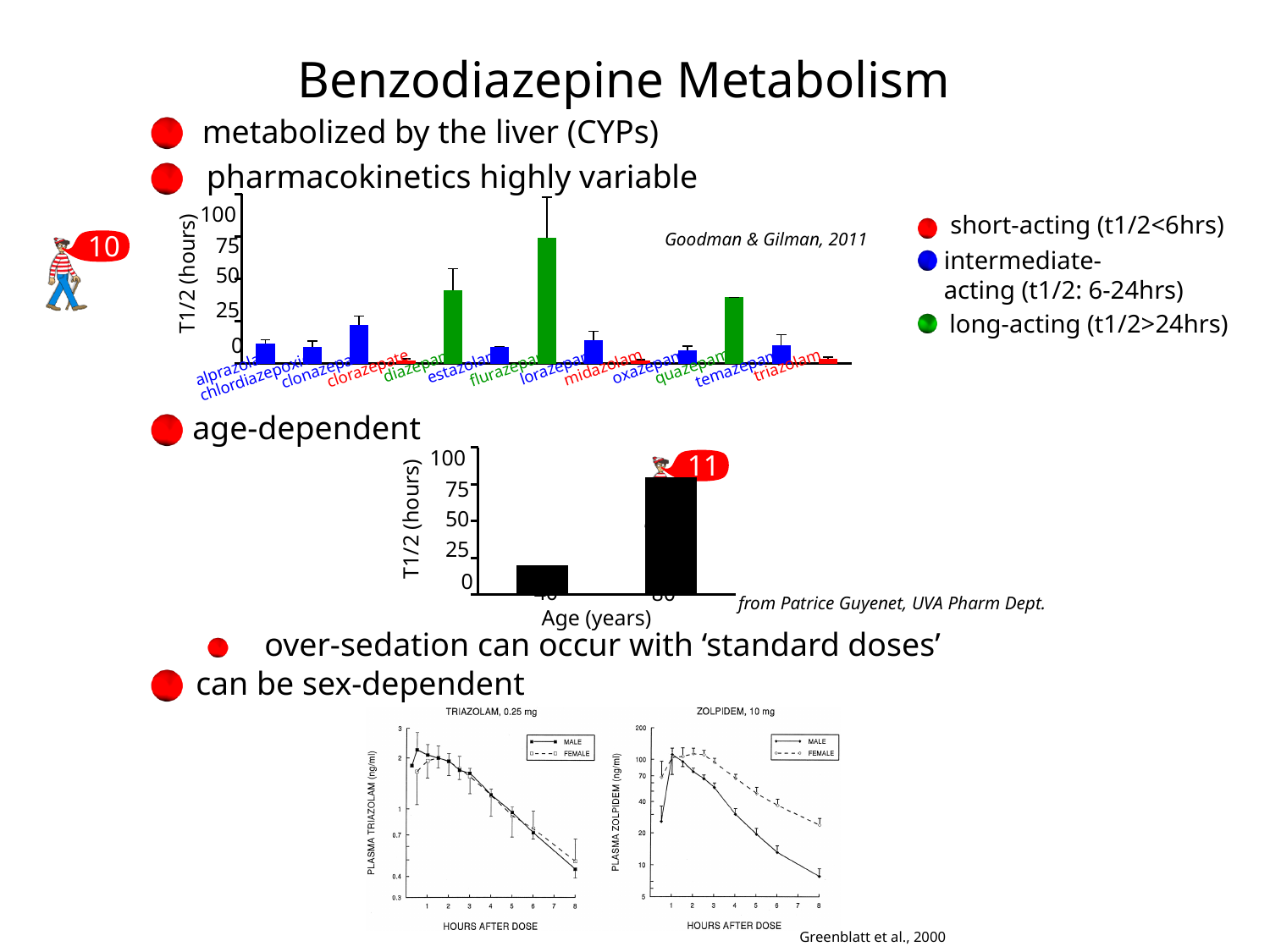
In the middle chart of T1/2 (hours) versus Age (years), how many bars are plotted? 2 In the bottom-left TRIAZOLAM, 0.25 mg chart, how many series does the legend list? 2 In the top T1/2 (hours) chart, what colour are the bars for long-acting drugs? green In the top T1/2 (hours) chart, which has the larger half-life, diazepam or lorazepam? diazepam In the top T1/2 (hours) chart, is the value for diazepam greater or less than 25? greater In the top T1/2 (hours) chart, is the value for flurazepam greater or less than 50? greater In the top T1/2 (hours) chart, is the value for triazolam greater or less than 25? less In the bottom-right ZOLPIDEM, 10 mg chart, does the MALE plasma zolpidem level rise or fall from hour 2 to hour 8? fall In the top T1/2 (hours) chart, which drug has the highest half-life? flurazepam In the top T1/2 (hours) chart, how many drugs are plotted along the x axis? 13 What kind of chart is the top chart showing T1/2 (hours) for the benzodiazepines? bar chart